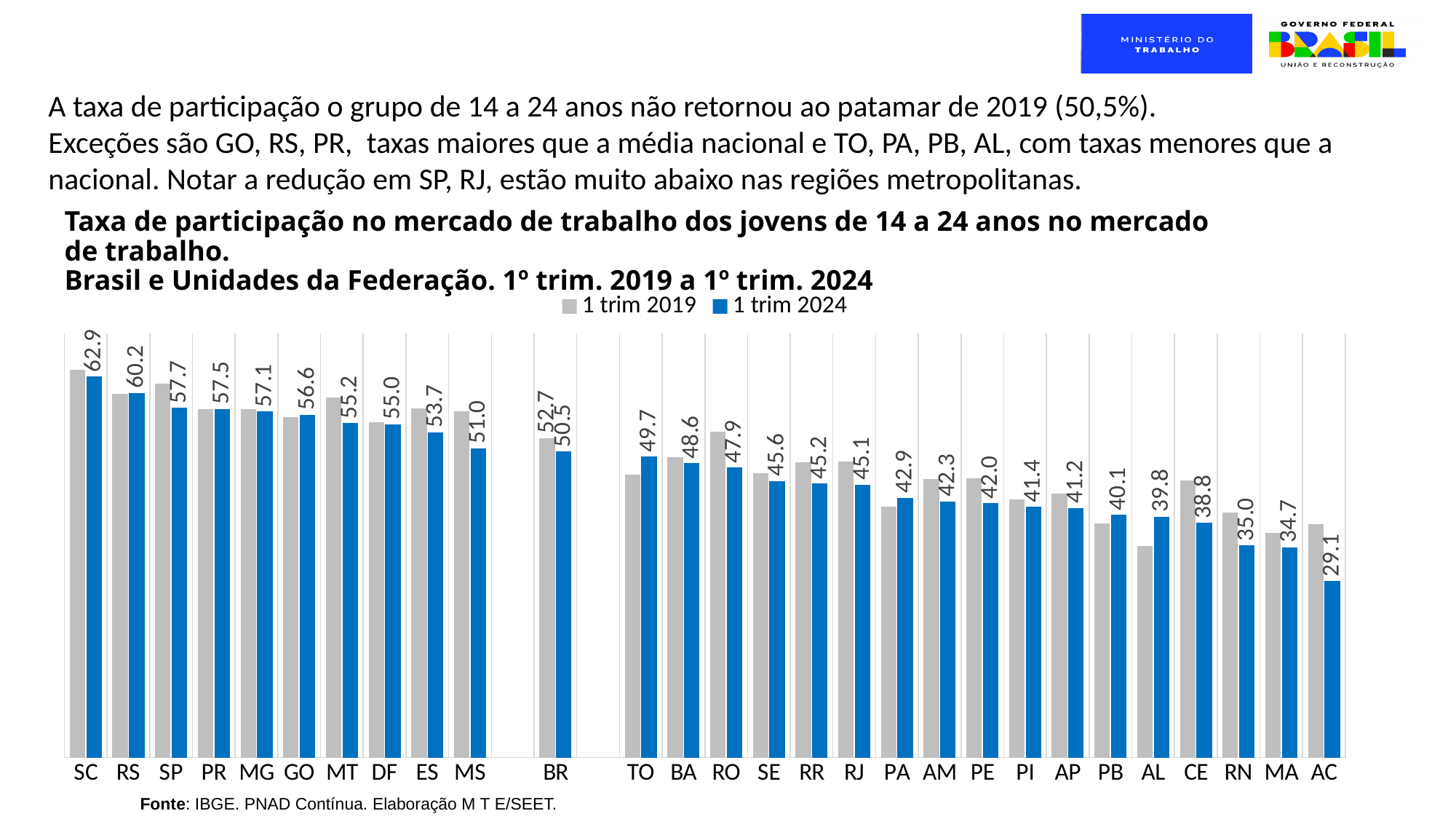
Which category has the lowest value in the 1 trim 2024 series? AC What is the difference between the 1 trim 2019 and 1 trim 2024 values for BR? 2.2 How many categories are shown on the x axis of the chart? 28 What is the value for BR in the 1 trim 2024 series? 50.5 What is the difference between the 1 trim 2024 values for SC and AC? 33.8 What is the value for SC in the 1 trim 2024 series? 62.9 Which category has the highest value in the 1 trim 2024 series? SC How many series does the legend list? 2 What kind of chart is shown on the slide? Bar chart What is the value for BR in the 1 trim 2019 series? 52.7 What is the value for AC in the 1 trim 2024 series? 29.1 In the 1 trim 2024 series, which is larger: GO or MT? GO